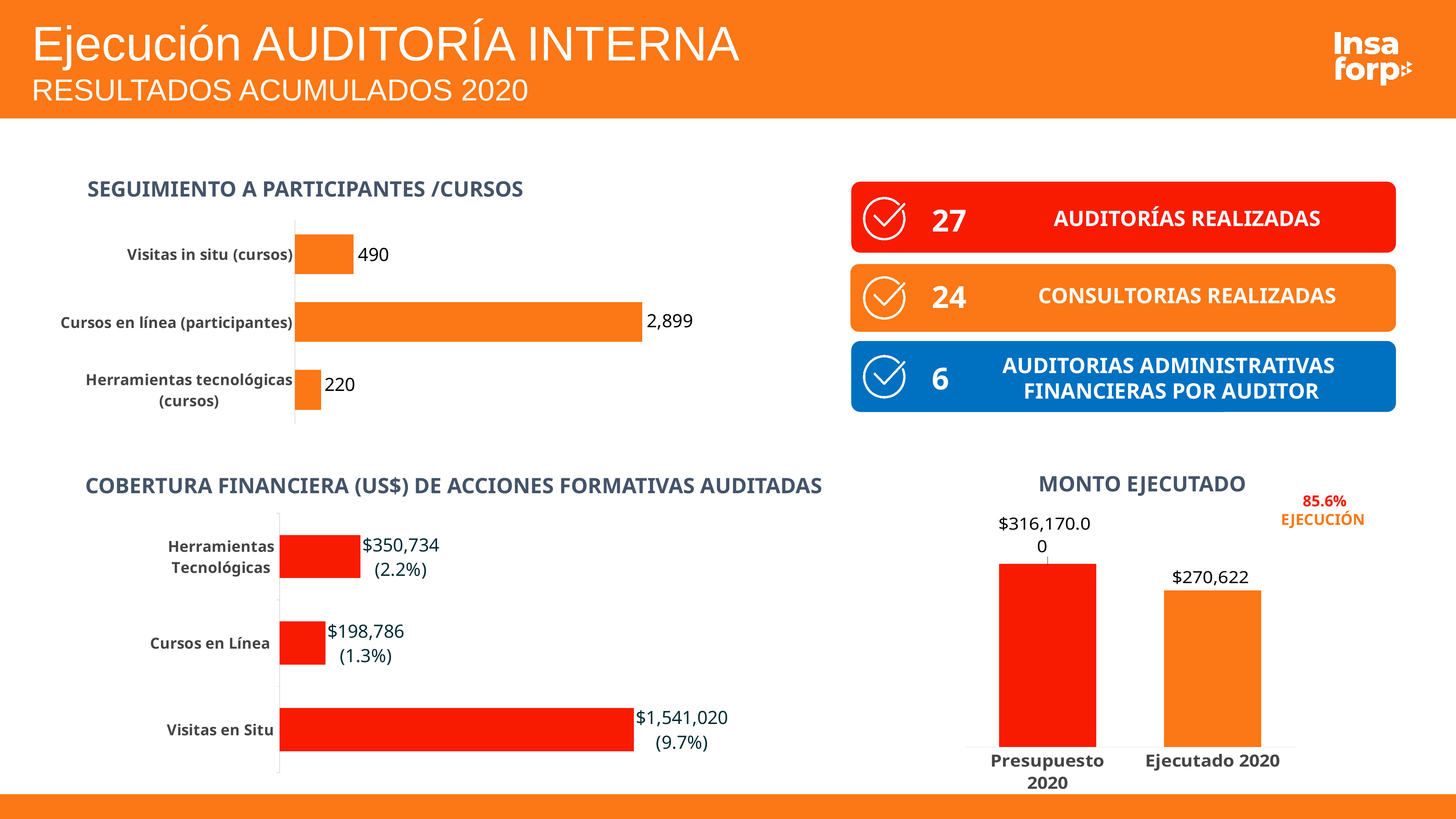
In the 'MONTO EJECUTADO' chart, which is larger, Presupuesto 2020 or Ejecutado 2020? Presupuesto 2020 In the 'COBERTURA FINANCIERA (US$) DE ACCIONES FORMATIVAS AUDITADAS' chart, what is the value for Cursos en Línea? $198,786 In the 'SEGUIMIENTO A PARTICIPANTES /CURSOS' chart, what is the value for Herramientas tecnológicas (cursos)? 220 In the 'SEGUIMIENTO A PARTICIPANTES /CURSOS' chart, which category has the lowest value? Herramientas tecnológicas (cursos) In the 'COBERTURA FINANCIERA (US$) DE ACCIONES FORMATIVAS AUDITADAS' chart, which category has the highest value? Visitas en Situ In the 'COBERTURA FINANCIERA (US$) DE ACCIONES FORMATIVAS AUDITADAS' chart, what percentage is shown next to Herramientas Tecnológicas? 2.2% In the 'MONTO EJECUTADO' chart, what is the value for Ejecutado 2020? $270,622 In the 'SEGUIMIENTO A PARTICIPANTES /CURSOS' chart, what is the value for Cursos en línea (participantes)? 2,899 In the 'SEGUIMIENTO A PARTICIPANTES /CURSOS' chart, what is the difference between Cursos en línea (participantes) and Visitas in situ (cursos)? 2,409 In the 'COBERTURA FINANCIERA (US$) DE ACCIONES FORMATIVAS AUDITADAS' chart, what is the difference between Visitas en Situ and Herramientas Tecnológicas? $1,190,286 In the 'SEGUIMIENTO A PARTICIPANTES /CURSOS' chart, how many categories are shown? 3 What kind of chart is 'MONTO EJECUTADO'? Bar chart